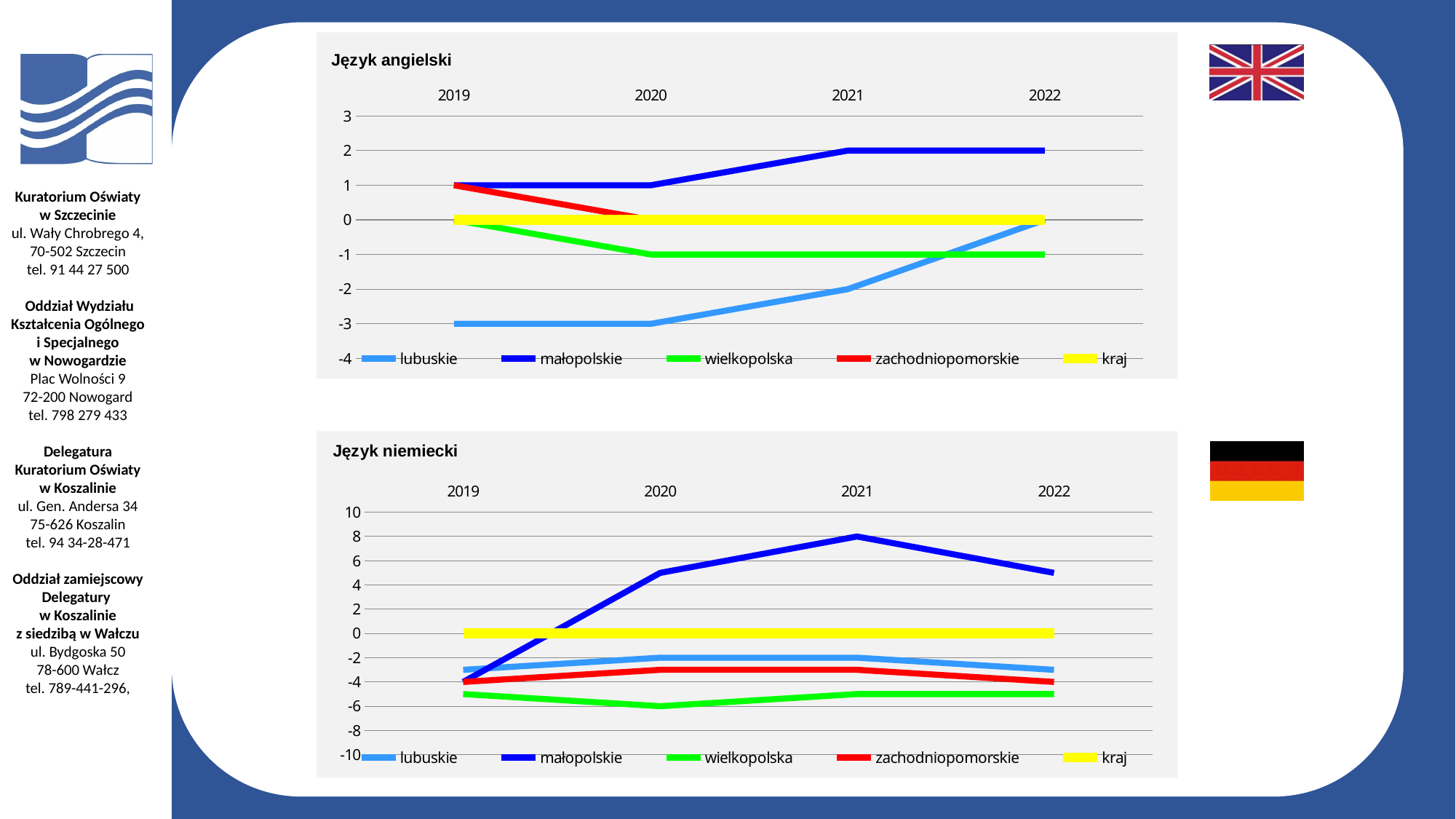
In the 'Język angielski' chart, what is the value for lubuskie in 2019? -3 In the 'Język niemiecki' chart, is the value for małopolskie in 2022 greater or less than 4? greater In the 'Język angielski' chart, which series has the highest value in 2022? małopolskie How many series does the legend of the 'Język niemiecki' chart list? 5 In the 'Język angielski' chart, what is the value for wielkopolska in 2021? -1 How many years are shown on the x axis of the 'Język angielski' chart? 4 In the 'Język angielski' chart, which series has the lowest value in 2019? lubuskie What type of chart is the 'Język angielski' chart? line chart In the 'Język angielski' chart, does the lubuskie line rise or fall from 2019 to 2022? rise In the 'Język niemiecki' chart, what is the value for małopolskie in 2021? 8 In the 'Język angielski' chart, what is the difference between małopolskie and lubuskie in 2022? 2 In the 'Język angielski' chart, what is the value for małopolskie in 2022? 2